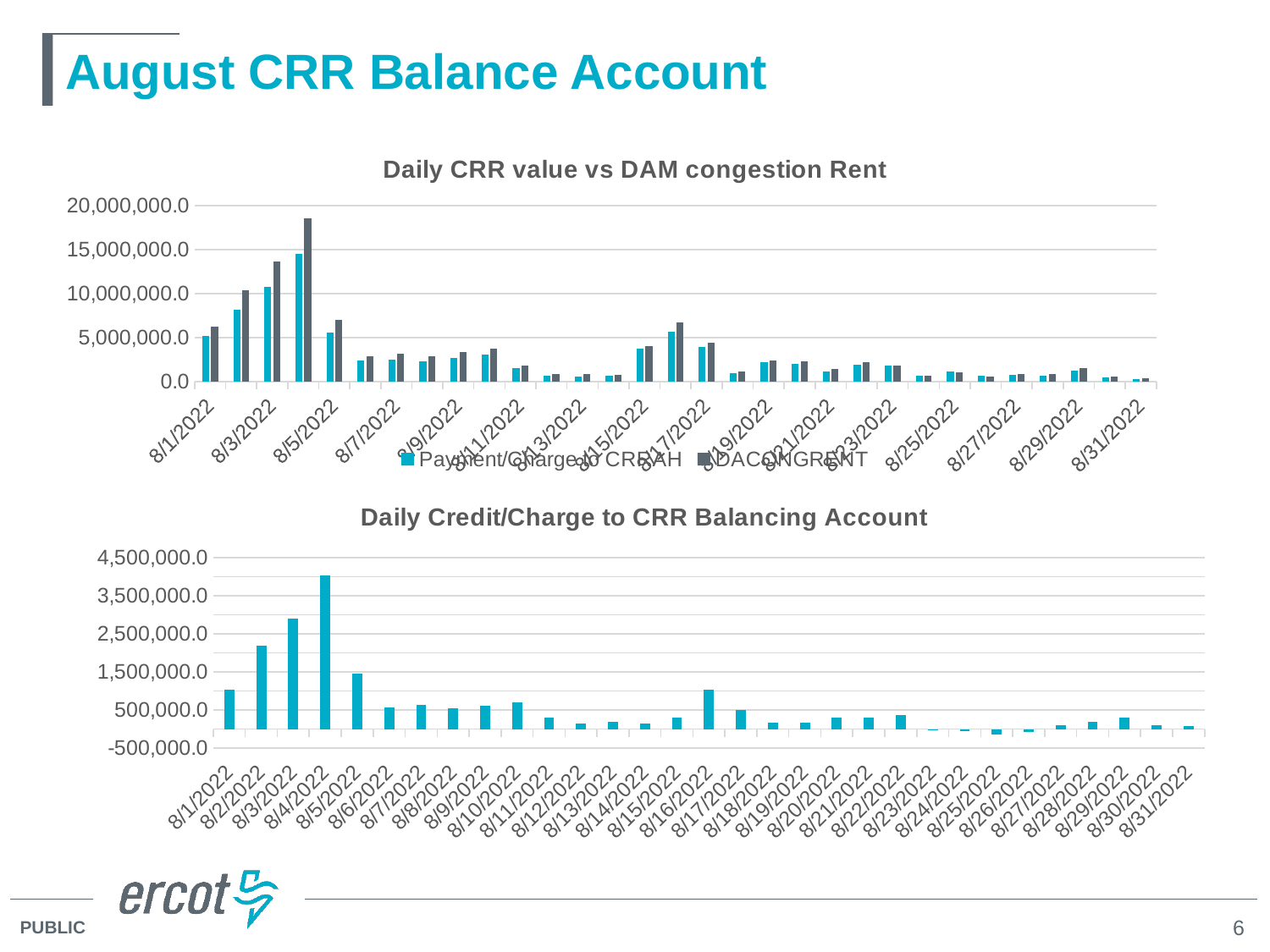
In the top chart, 'Daily CRR value vs DAM congestion Rent', which series has the larger value on 8/5/2022? DACONGRENT In the bottom chart, 'Daily Credit/Charge to CRR Balancing Account', which date has the highest value? 8/4/2022 In the top chart, 'Daily CRR value vs DAM congestion Rent', is the Payment/Charge to CRRAH value for 8/2/2022 greater or less than 5,000,000.0? greater In the bottom chart, 'Daily Credit/Charge to CRR Balancing Account', how many dates are shown on the x axis? 31 What kind of chart is the bottom chart, 'Daily Credit/Charge to CRR Balancing Account'? bar chart In the bottom chart, 'Daily Credit/Charge to CRR Balancing Account', which is larger, the value for 8/2/2022 or 8/3/2022? 8/3/2022 In the top chart, 'Daily CRR value vs DAM congestion Rent', how many series does the legend list? 2 In the bottom chart, 'Daily Credit/Charge to CRR Balancing Account', do the values rise or fall from 8/4/2022 to 8/8/2022? fall In the top chart, 'Daily CRR value vs DAM congestion Rent', on which date is the DACONGRENT bar highest? 8/4/2022 In the top chart, 'Daily CRR value vs DAM congestion Rent', is the DACONGRENT value for 8/4/2022 greater or less than 10,000,000.0? greater In the top chart, 'Daily CRR value vs DAM congestion Rent', is the DACONGRENT value for 8/5/2022 greater or less than 15,000,000.0? less